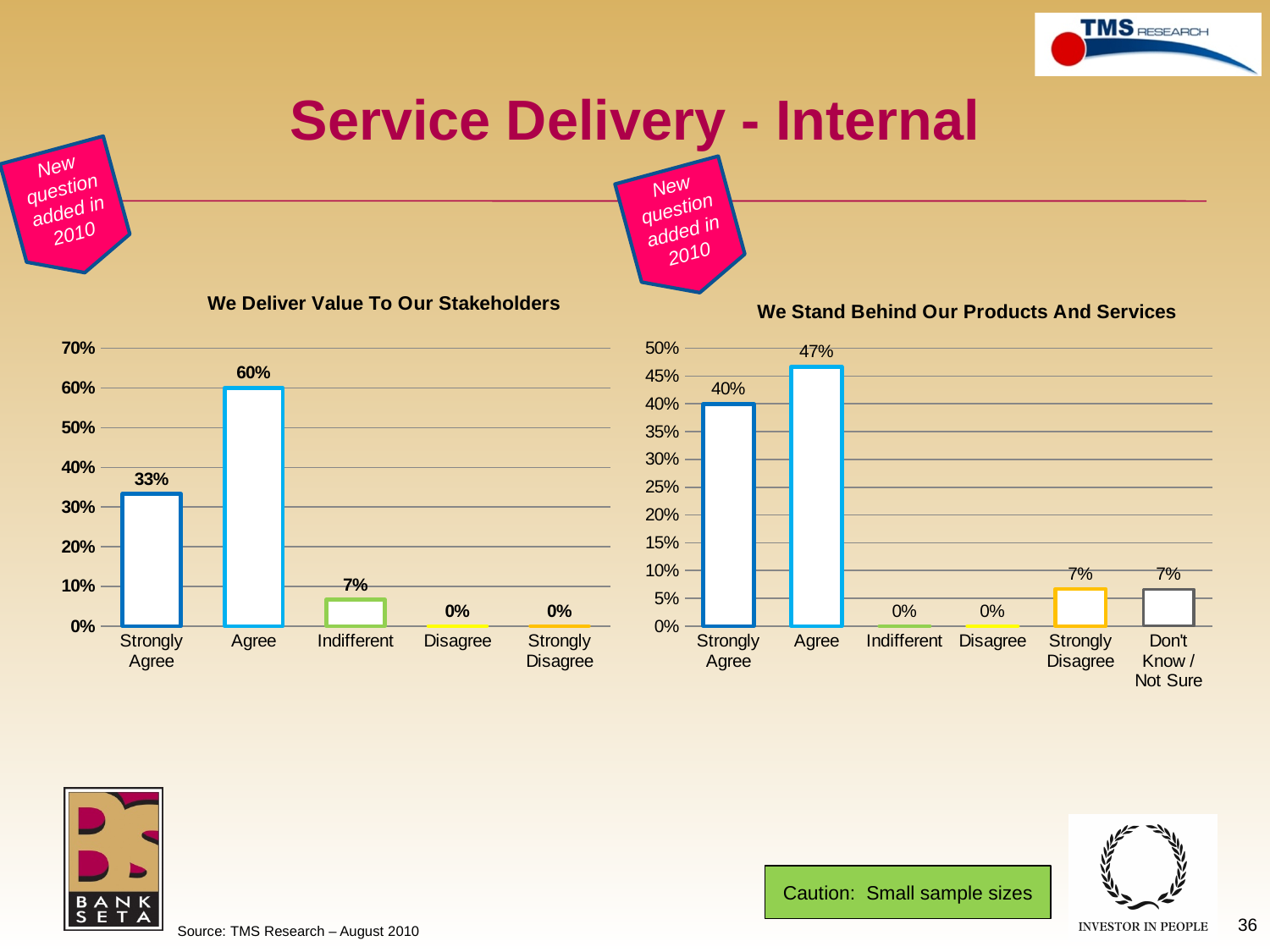
In the 'We Stand Behind Our Products And Services' chart, which category has the highest value? Agree In the 'We Deliver Value To Our Stakeholders' chart, what is the difference between Agree and Strongly Agree? 27% In the 'We Stand Behind Our Products And Services' chart, what is the value for Don't Know / Not Sure? 7% In the 'We Deliver Value To Our Stakeholders' chart, how many categories are shown on the x axis? 5 In the 'We Stand Behind Our Products And Services' chart, how many categories are shown on the x axis? 6 What type of chart is the 'We Stand Behind Our Products And Services' chart? Bar chart In the 'We Stand Behind Our Products And Services' chart, what is the value for Strongly Agree? 40% In the 'We Deliver Value To Our Stakeholders' chart, which category has the highest value? Agree In the 'We Stand Behind Our Products And Services' chart, what is the difference between Agree and Strongly Agree? 7% In the 'We Deliver Value To Our Stakeholders' chart, what is the value for Strongly Agree? 33% Which is larger: Agree in the 'We Deliver Value To Our Stakeholders' chart or Agree in the 'We Stand Behind Our Products And Services' chart? Agree in 'We Deliver Value To Our Stakeholders' In the 'We Deliver Value To Our Stakeholders' chart, what is the value for Agree? 60%